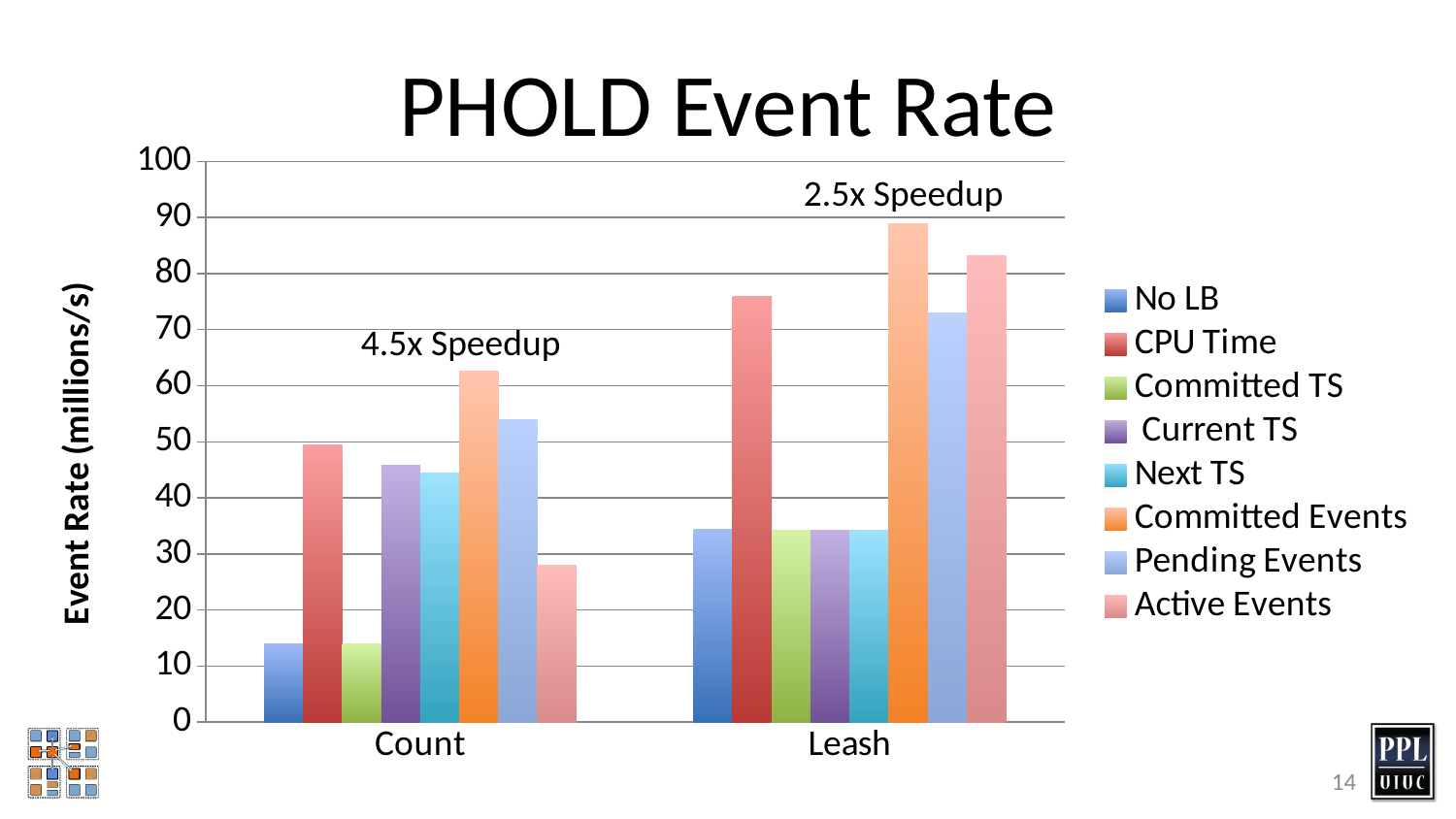
Which series has the highest value for the Count category? Committed Events What speedup annotation is shown above the Count bars? 4.5x Speedup How many series does the legend list? 8 For the Count category, which is larger: Pending Events or Current TS? Pending Events Which series has the highest value for the Leash category? Committed Events What kind of chart is shown on the slide? bar chart Is the Committed Events value for Leash greater or less than 80? greater How many categories are shown on the x axis? 2 Is the Active Events value for Count greater or less than 40? less Is the CPU Time value for Count greater or less than 40? greater For the Leash category, which is larger: Pending Events or Active Events? Active Events What is the label on the y axis? Event Rate (millions/s)